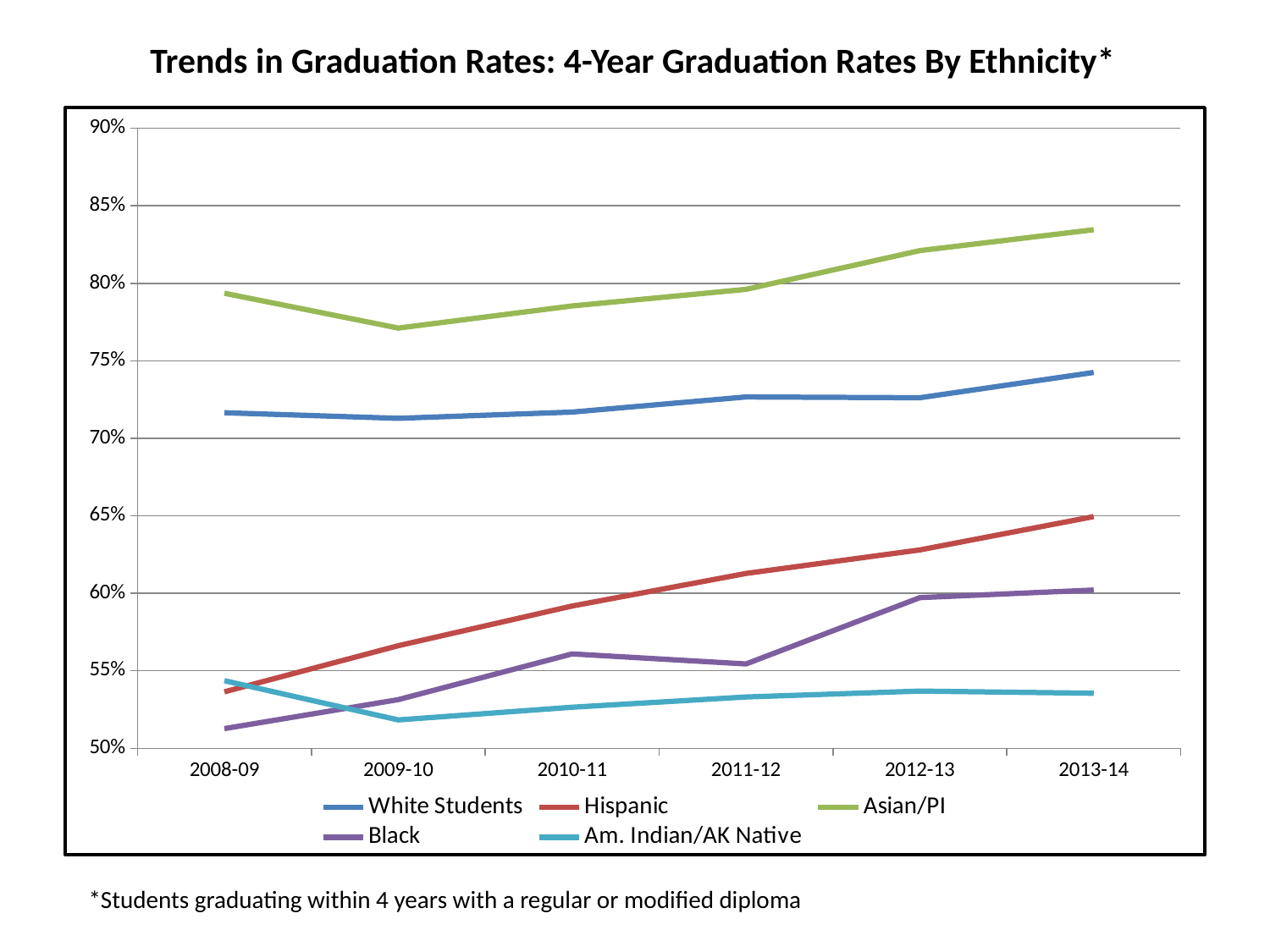
Is the value for Hispanic in 2011-12 greater or less than 60%? greater Does the Hispanic graduation rate rise or fall from 2008-09 to 2013-14? rise In 2008-09, which is larger: the value for Black or the value for Am. Indian/AK Native? Am. Indian/AK Native What kind of chart is shown on the slide? line chart How many school years are shown on the x axis? 6 Is the value for Black in 2008-09 greater or less than 55%? less Is the value for Asian/PI in 2009-10 greater or less than 80%? less Which group has the lowest graduation rate in 2008-09? Black Which group has the highest graduation rate in 2013-14? Asian/PI Which group has the lowest graduation rate in 2013-14? Am. Indian/AK Native How many series does the legend list? 5